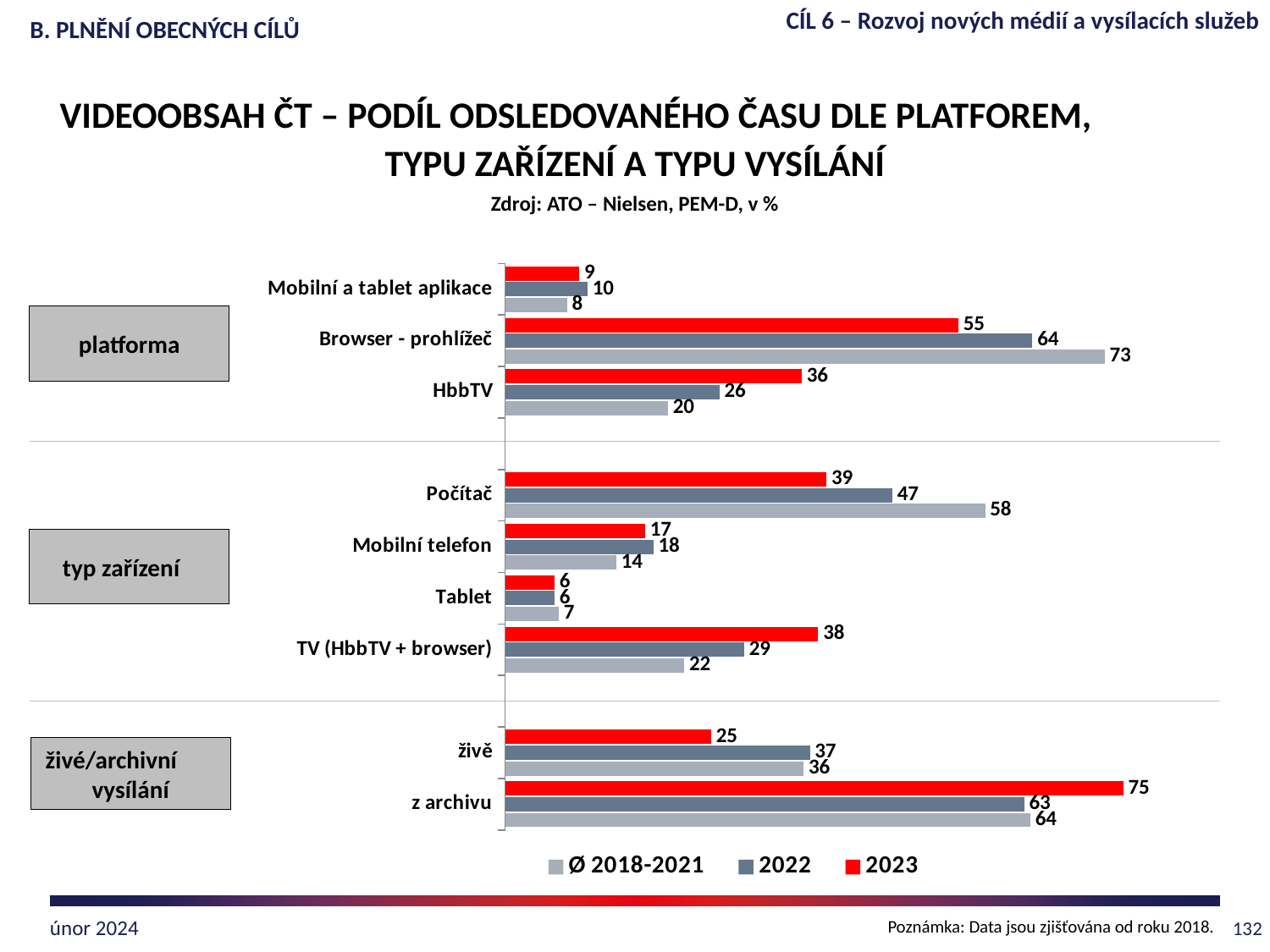
Which category has the lowest Ø 2018-2021 value? Tablet What is the 2023 value for z archivu? 75 Which category has the highest 2023 value? z archivu What is the Ø 2018-2021 value for HbbTV? 20 What kind of chart is shown on the slide? bar chart What is the 2023 value for Browser - prohlížeč? 55 What is the 2022 value for Počítač? 47 For TV (HbbTV + browser), which is larger: the 2023 value or the 2022 value? 2023 What is the difference between the Ø 2018-2021 value and the 2023 value for Browser - prohlížeč? 18 Which colour represents the 2023 series in the chart? red How many categories are shown on the chart? 9 How many series does the legend list? 3